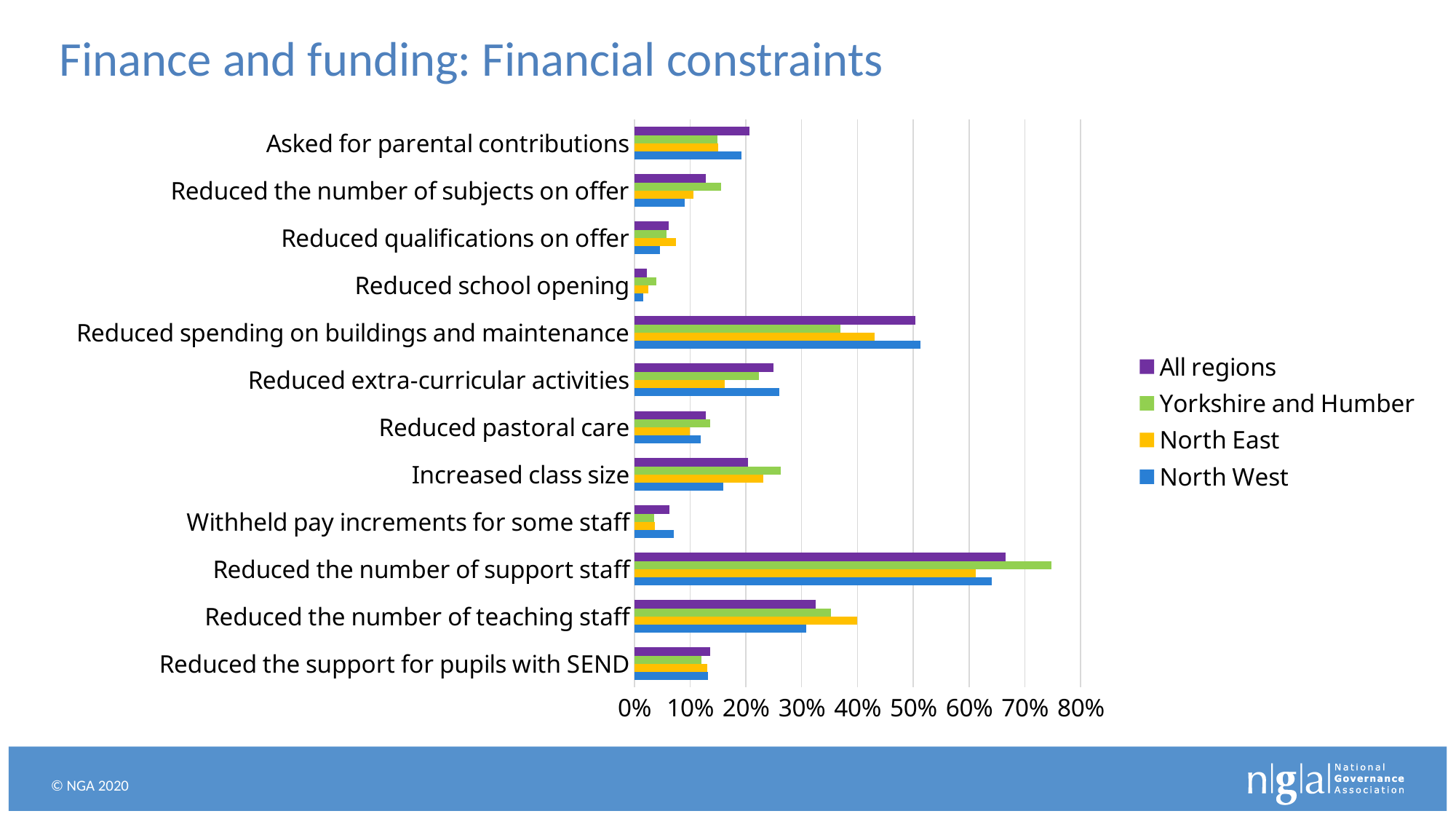
For Reduced spending on buildings and maintenance, which is larger: North West or Yorkshire and Humber? North West What is the title of the slide containing the chart? Finance and funding: Financial constraints Which category has the lowest value for All regions? Reduced school opening Which category has the highest value for Yorkshire and Humber? Reduced the number of support staff Is the North East value for Reduced the number of teaching staff greater or less than 30%? greater How many categories are plotted on the chart? 12 For Increased class size, which is larger: Yorkshire and Humber or North West? Yorkshire and Humber Is the North East value for Reduced extra-curricular activities greater or less than 20%? less How many series does the legend list? 4 What kind of chart is shown on the slide? bar chart Is the Yorkshire and Humber value for Reduced the number of support staff greater or less than 70%? greater